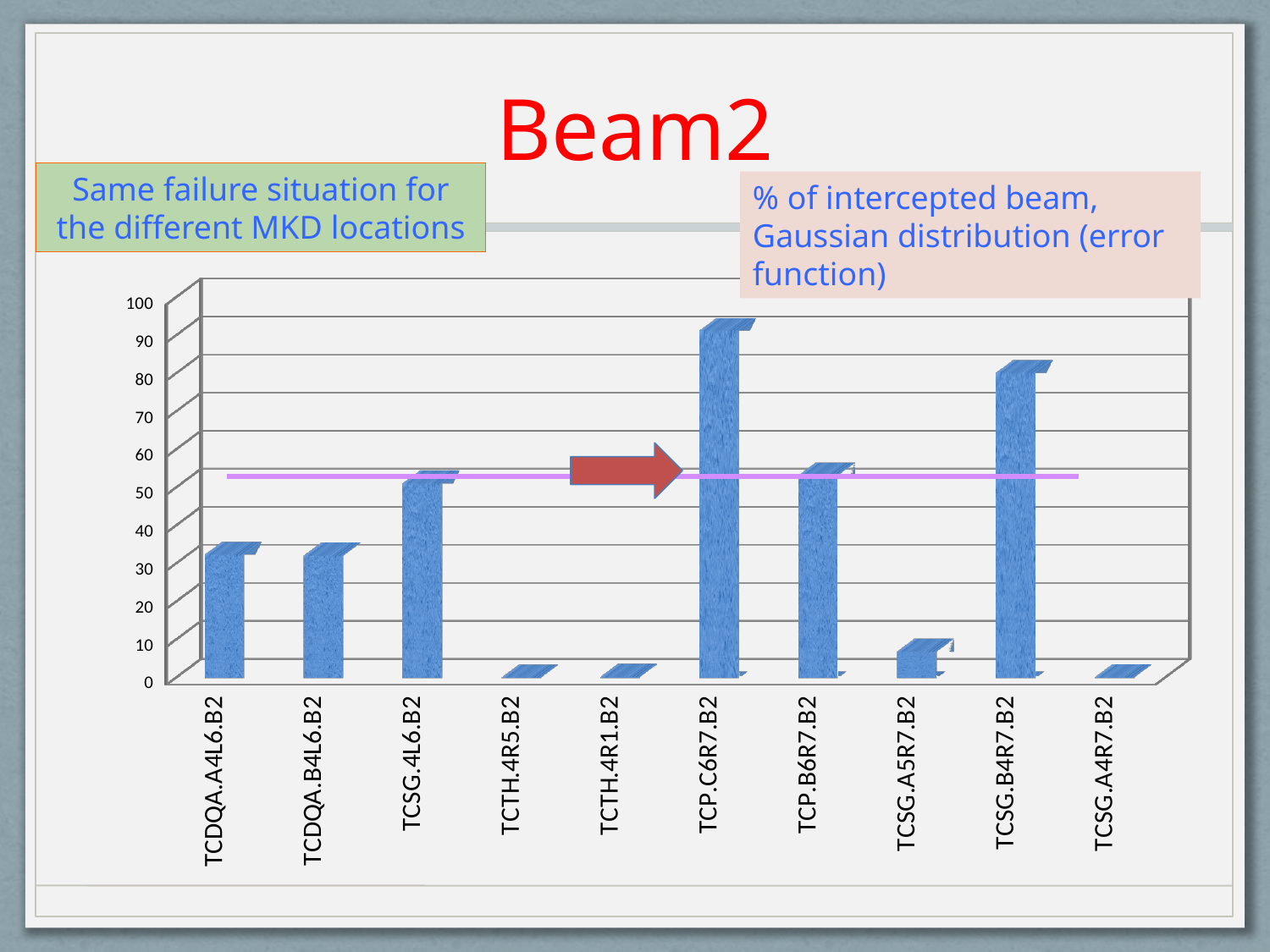
Is the value for TCDQA.A4L6.B2 greater or less than 40? less Is the value for TCSG.A5R7.B2 greater or less than 20? less Which is larger, the value for TCSG.B4R7.B2 or the value for TCDQA.B4L6.B2? TCSG.B4R7.B2 How many collimator categories are plotted along the x axis of the chart? 10 What is the maximum value shown on the vertical axis of the chart? 100 Which category has the highest bar in the chart? TCP.C6R7.B2 Is the value for TCP.B6R7.B2 greater or less than 40? greater What kind of chart is shown on the slide? Bar chart Which is larger, the value for TCP.C6R7.B2 or the value for TCP.B6R7.B2? TCP.C6R7.B2 What is the title of the slide containing the chart? Beam2